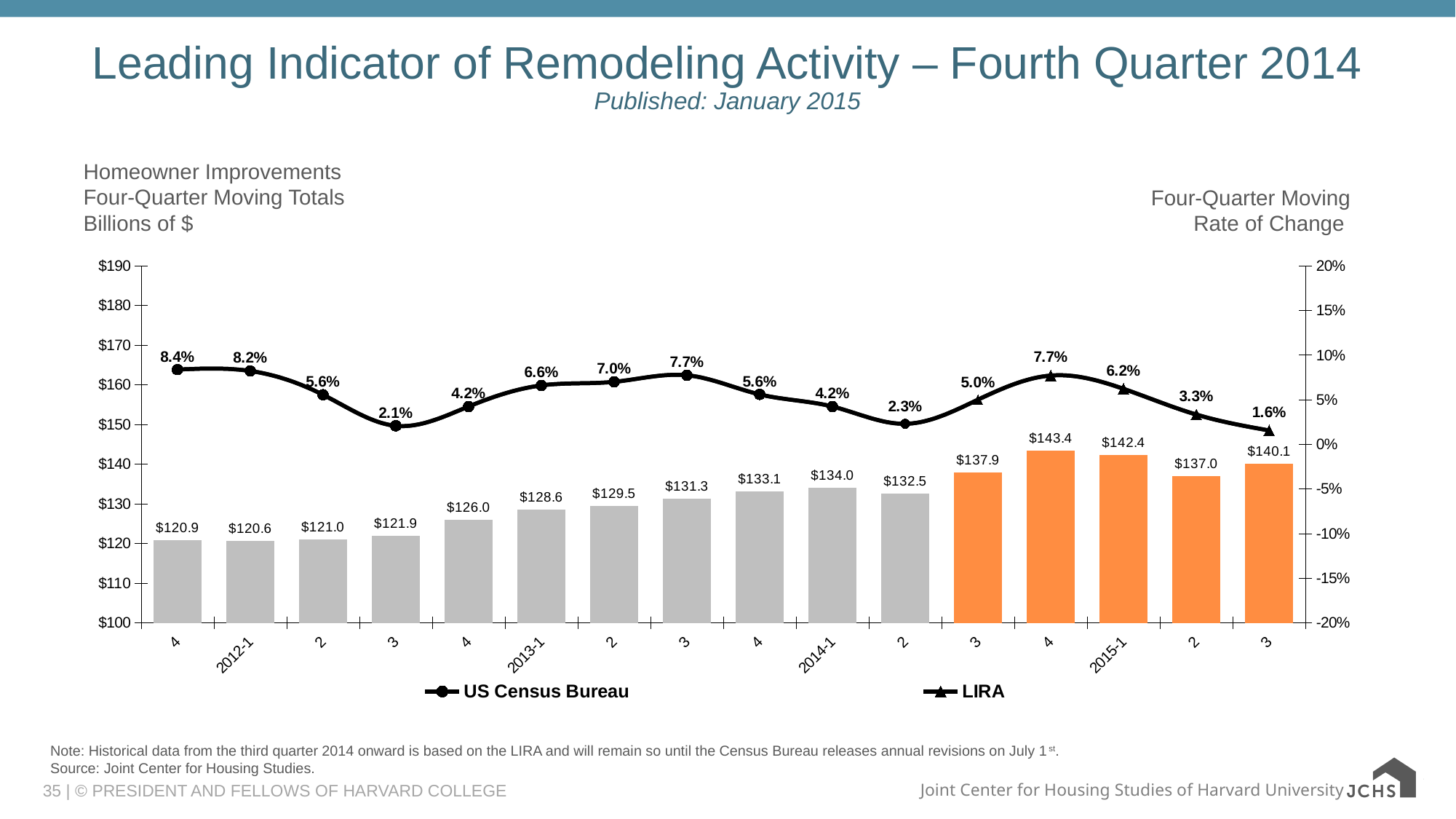
What is the four-quarter moving total for 2014-1? $134.0 What is the difference between the four-quarter moving totals for 2015-1 and 2014-1? $8.4 What is the four-quarter moving total for 2015-1? $142.4 What is the four-quarter moving rate of change for 2013-1? 6.6% How many bars are plotted in the chart? 16 How many series does the legend list? 2 What kind of chart is shown on the slide? Combined bar and line chart What are the two series named in the legend? US Census Bureau and LIRA What is the four-quarter moving rate of change for the last quarter shown (2015 quarter 3)? 1.6% Which is larger, the rate of change for 2012-1 or for 2013-1? 2012-1 (8.2%) Which quarter has the highest four-quarter moving total? 2014 quarter 4 ($143.4) Which quarter has the lowest four-quarter moving total? 2012-1 ($120.6)